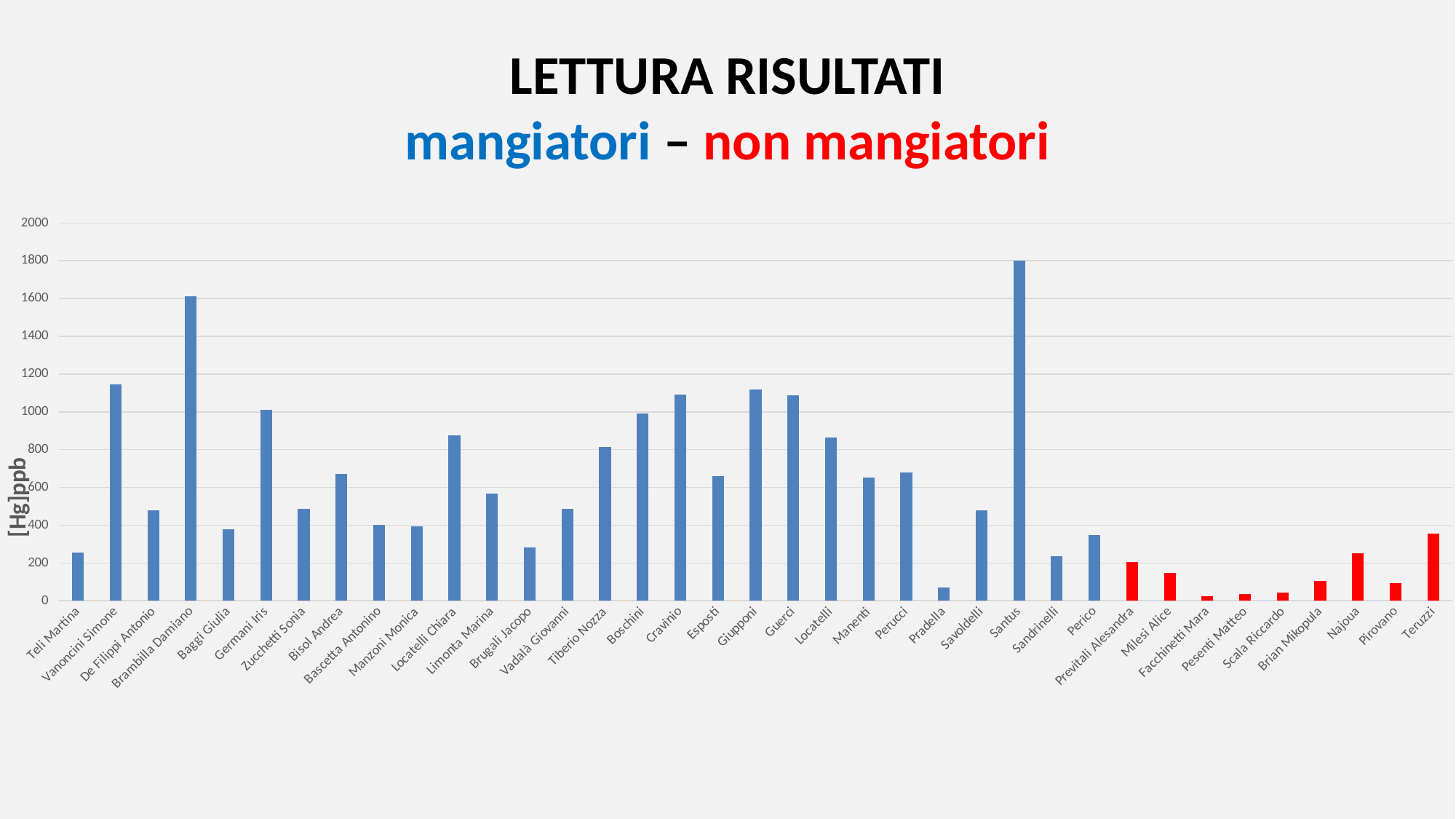
What is the label on the vertical axis of the chart? [Hg]ppb What kind of chart is shown on the slide? bar chart Is the value for Teruzzi greater or less than 200? greater Is the value for Brambilla Damiano greater or less than 1400? greater Is the value for Pradella greater or less than 200? less How many red bars (non mangiatori) are there in the chart? 9 Which person has the lowest value in the chart? Facchinetti Mara Which is larger, the value for Teruzzi or the value for Najoua? Teruzzi Which is larger, the value for Brambilla Damiano or the value for Vanoncini Simone? Brambilla Damiano How many bars are plotted in the chart? 37 Which person has the highest value in the chart? Santus